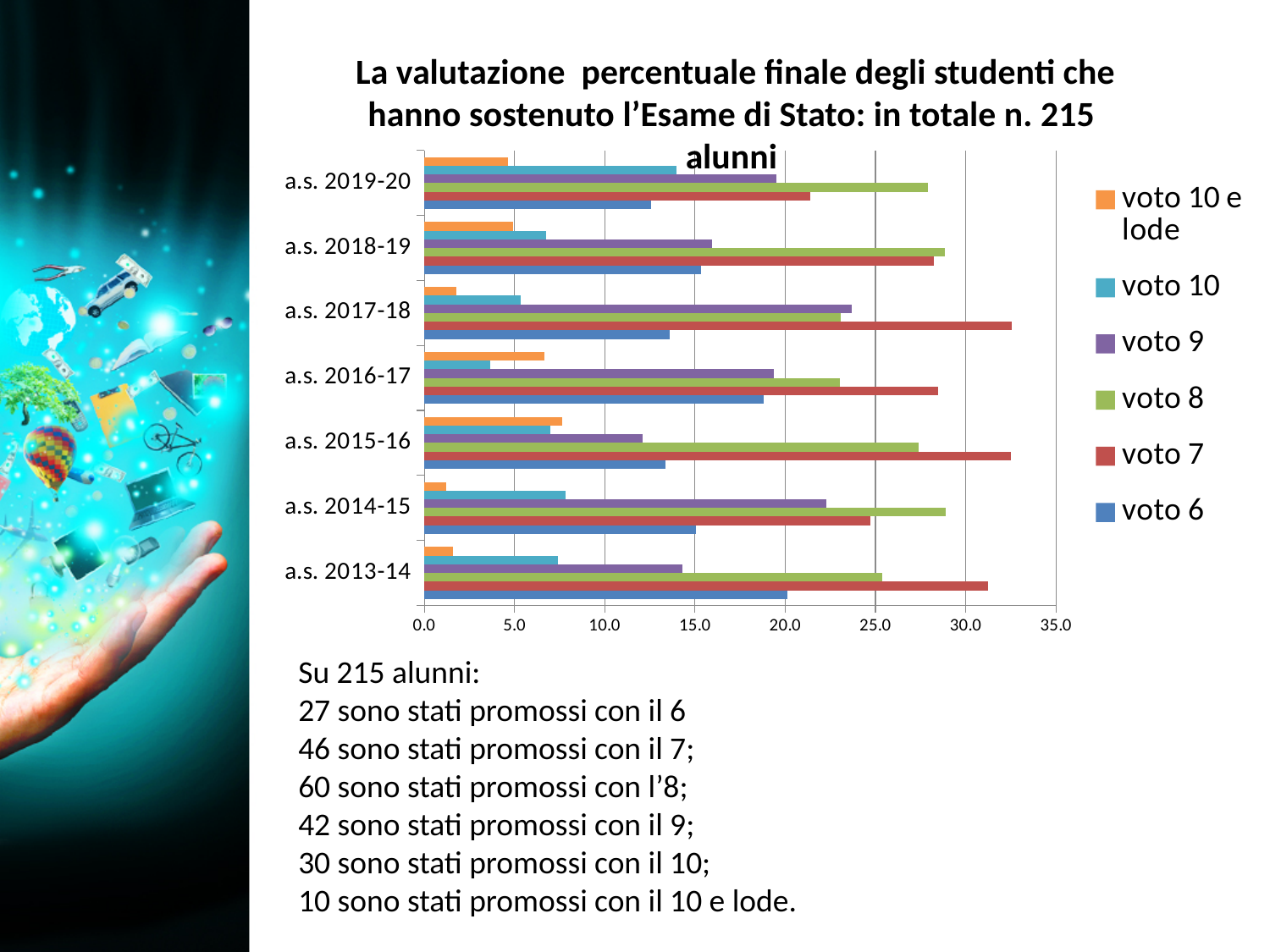
How many series does the chart legend list? 6 Is the value for voto 10 e lode in a.s. 2014-15 greater or less than 5.0? less Is the value for voto 8 in a.s. 2019-20 greater or less than 25.0? greater Is the value for voto 6 in a.s. 2013-14 greater or less than 15.0? greater In a.s. 2015-16, which is larger: voto 7 or voto 9? voto 7 What kind of chart is shown on the slide? bar chart Which series is listed first (at the top) in the chart legend? voto 10 e lode Which series has the highest value in a.s. 2017-18? voto 7 In a.s. 2019-20, which is larger: voto 10 or voto 10 e lode? voto 10 How many school years (categories) are shown on the chart? 7